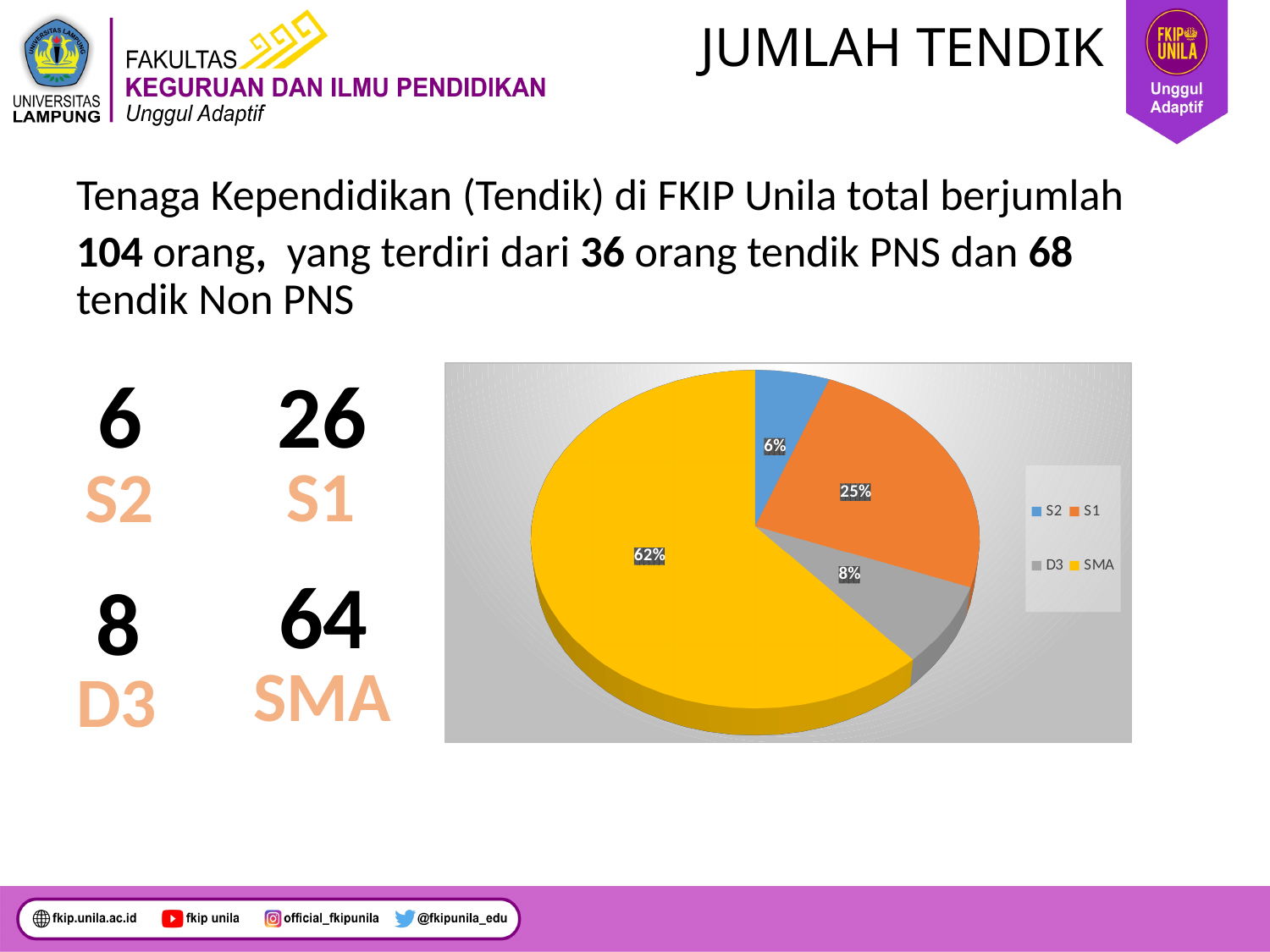
By how many percentage points does the SMA share exceed the S1 share in the pie chart? 37 percentage points Which category has the smallest slice in the pie chart? S2 What percentage share does the SMA slice have in the pie chart? 62% Which slice is larger in the pie chart, S1 or D3? S1 Which category has the largest slice in the pie chart? SMA How many slices does the pie chart have? 4 What percentage share does the D3 slice have in the pie chart? 8% How many entries does the legend of the pie chart list? 4 What colour is the SMA slice in the pie chart? Yellow What percentage share does the S2 slice have in the pie chart? 6% What kind of chart is shown on the slide? Pie chart